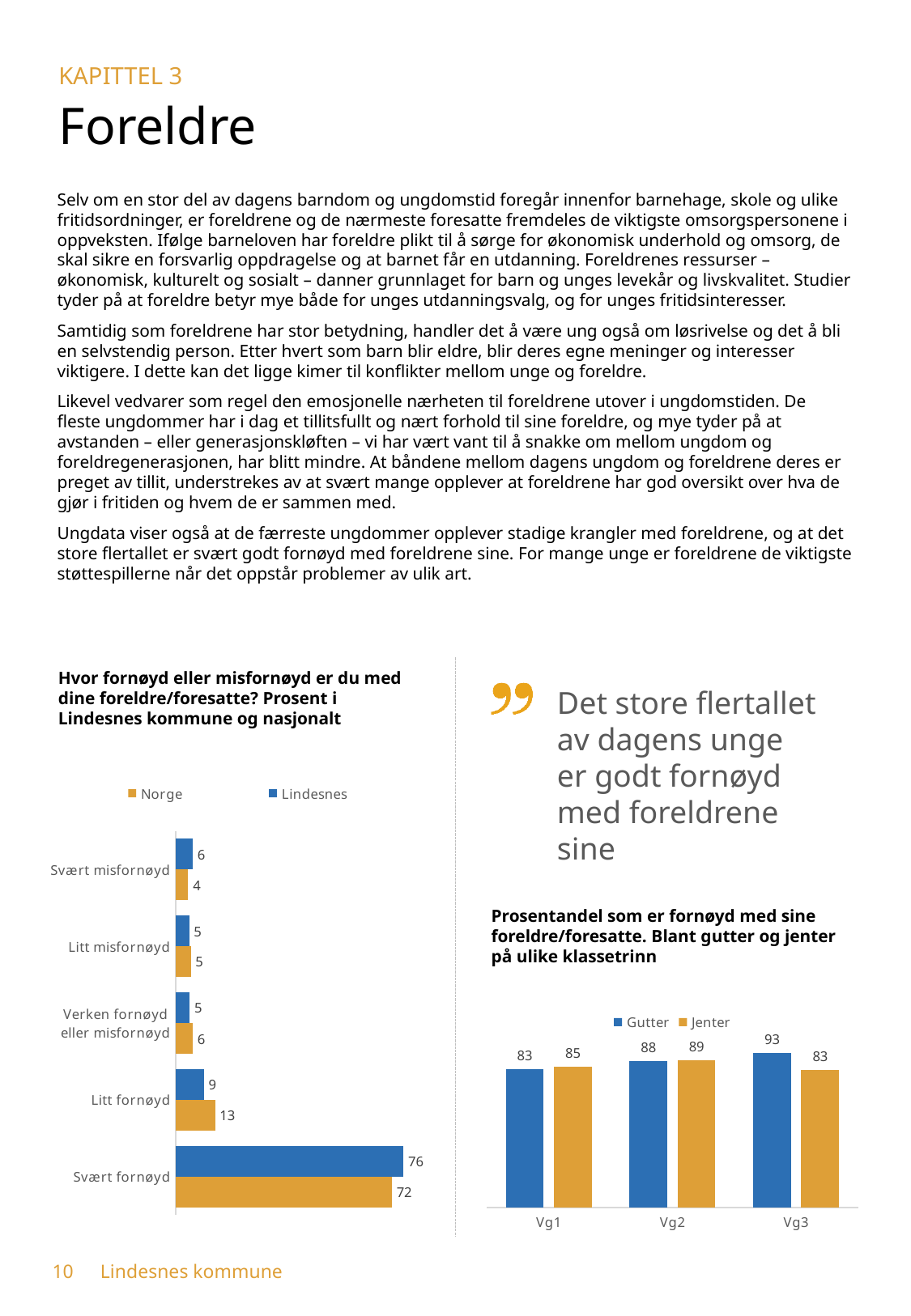
In the left chart (Hvor fornøyd eller misfornøyd er du med dine foreldre/foresatte?), which category has the highest Norge value? Svært fornøyd In the right chart (Prosentandel som er fornøyd med sine foreldre/foresatte), what is the Gutter value for Vg3? 93 In the right chart (Prosentandel som er fornøyd med sine foreldre/foresatte), do the Gutter values rise or fall from Vg1 to Vg3? Rise In the right chart (Prosentandel som er fornøyd med sine foreldre/foresatte), how many series does the legend list? 2 In the left chart (Hvor fornøyd eller misfornøyd er du med dine foreldre/foresatte?), what is the Norge value for Litt fornøyd? 13 In the left chart (Hvor fornøyd eller misfornøyd er du med dine foreldre/foresatte?), what is the Lindesnes value for Svært fornøyd? 76 In the right chart (Prosentandel som er fornøyd med sine foreldre/foresatte), what is the Jenter value for Vg2? 89 In the left chart (Hvor fornøyd eller misfornøyd er du med dine foreldre/foresatte?), how many categories are shown? 5 In the right chart (Prosentandel som er fornøyd med sine foreldre/foresatte), what is the difference between Gutter and Jenter for Vg3? 10 In the left chart (Hvor fornøyd eller misfornøyd er du med dine foreldre/foresatte?), what is the difference between the Lindesnes and Norge values for Svært fornøyd? 4 In the left chart (Hvor fornøyd eller misfornøyd er du med dine foreldre/foresatte?), which is larger for Litt fornøyd, Norge or Lindesnes? Norge In the left chart (Hvor fornøyd eller misfornøyd er du med dine foreldre/foresatte?), what kind of chart is it? Bar chart